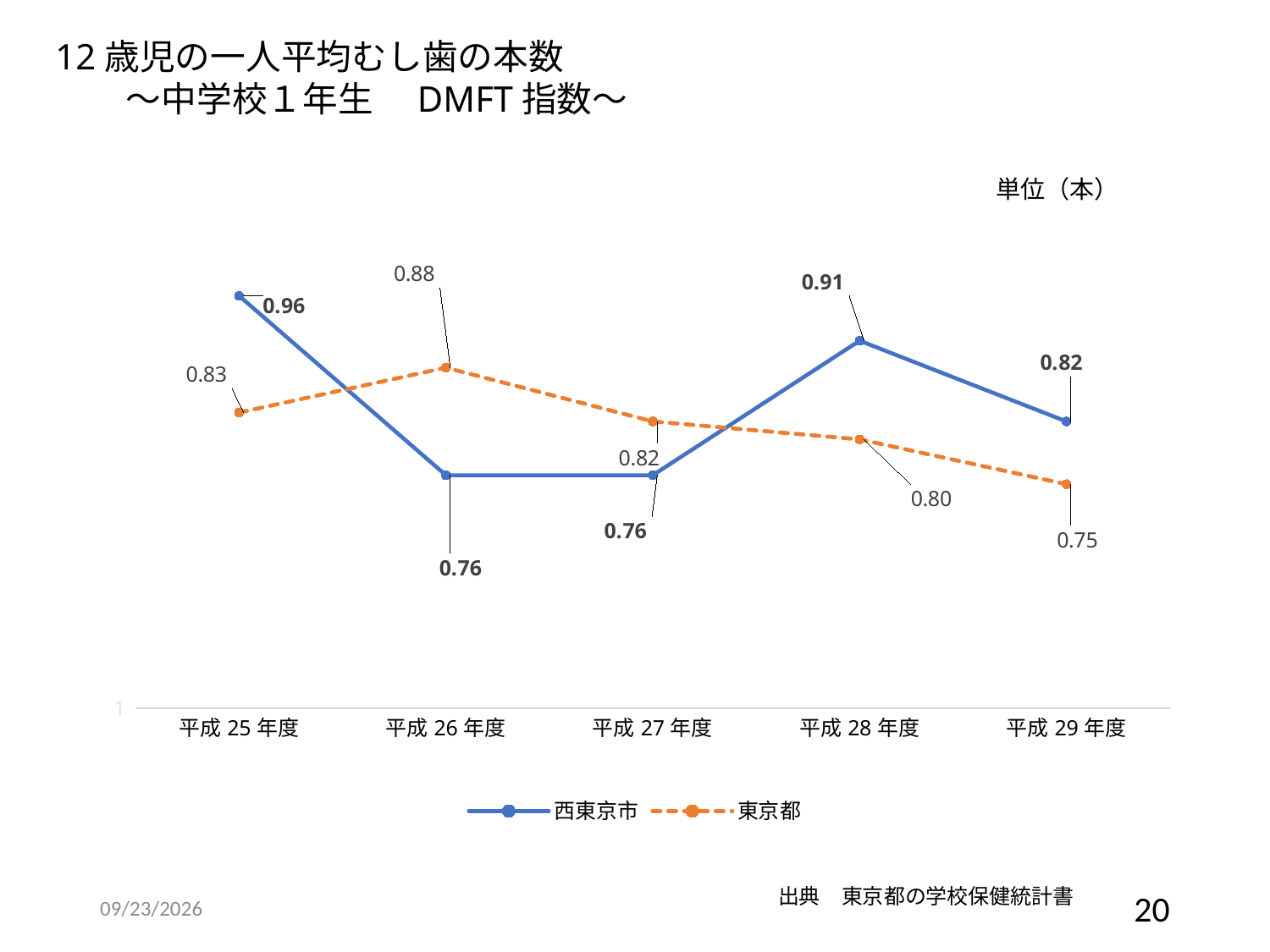
In which year is the value for 西東京市 highest? 平成25年度 What is the difference between 西東京市 and 東京都 in 平成28年度? 0.11 In which year is the value for 東京都 lowest? 平成29年度 What is the value for 西東京市 in 平成28年度? 0.91 How many years are shown on the x axis? 5 What is the value for 西東京市 in 平成25年度? 0.96 How many series does the legend list? 2 What is the value for 東京都 in 平成26年度? 0.88 What kind of chart is shown on the slide? Line chart Does the value for 東京都 rise or fall from 平成26年度 to 平成29年度? Fall What is the value for 東京都 in 平成29年度? 0.75 In 平成26年度, which series has the larger value, 西東京市 or 東京都? 東京都